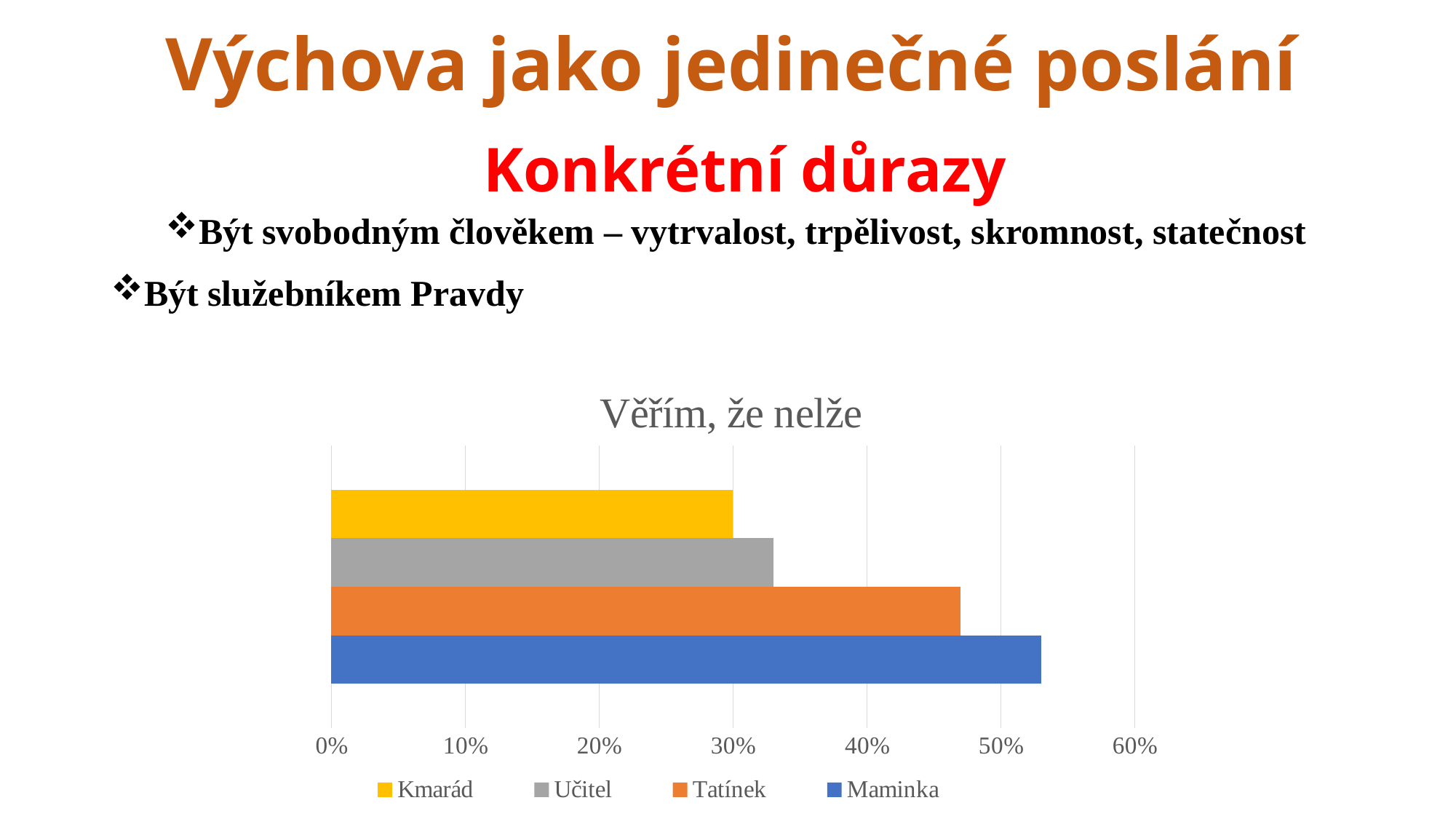
Which is larger, the value for Maminka or the value for Tatínek? Maminka How many series does the chart legend list? 4 Is the value for Učitel greater or less than 40%? less Is the value for Maminka greater or less than 50%? greater What kind of chart is shown on the slide? bar chart Which is larger, the value for Tatínek or the value for Učitel? Tatínek What colour is the bar for Maminka? blue Is the value for Tatínek greater or less than 50%? less Which series has the highest value in the chart? Maminka What is the title of the chart? Věřím, že nelže Which series has the lowest value in the chart? Kmarád